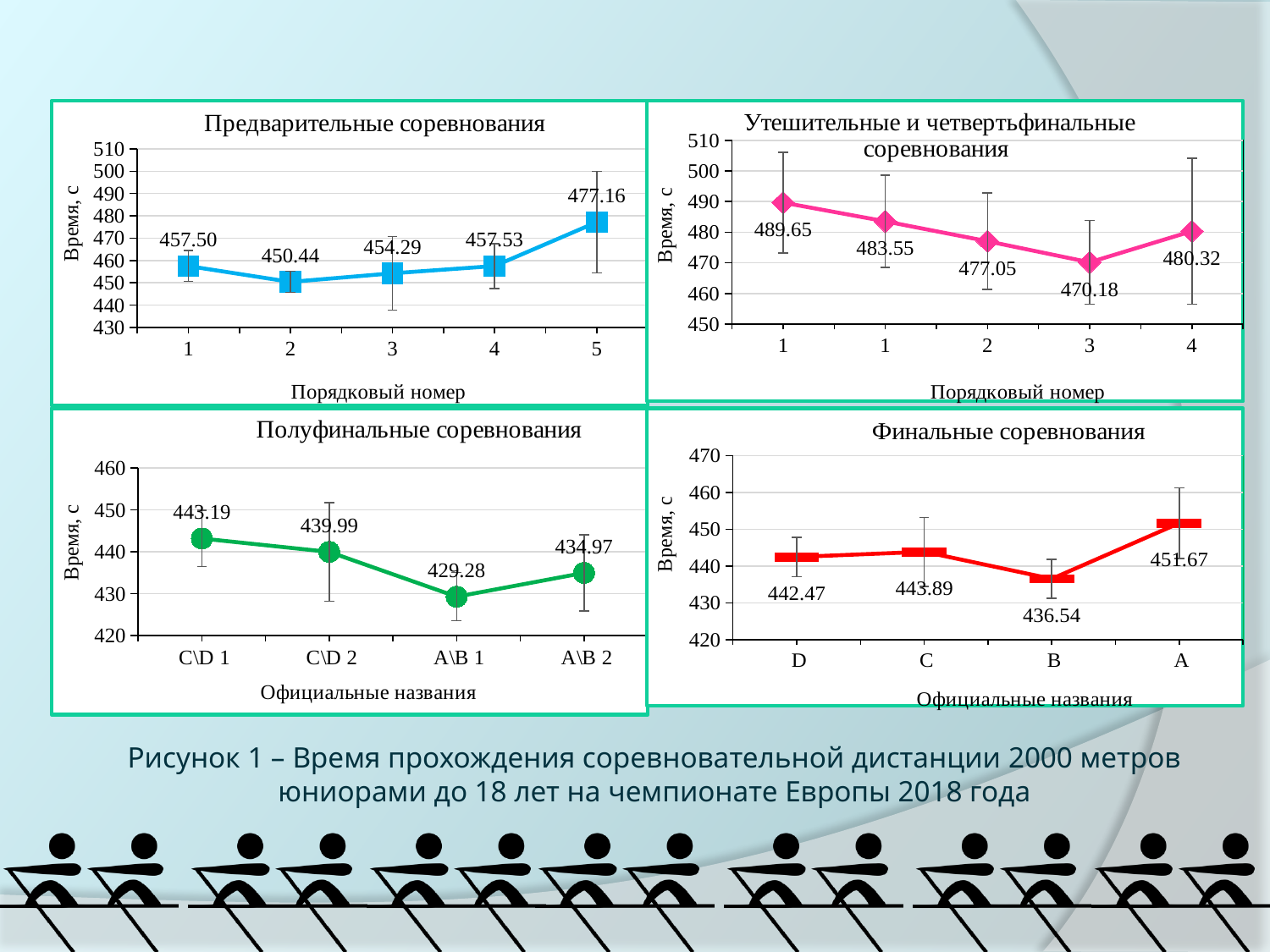
In the chart titled "Финальные соревнования", what is the value for A? 451.67 In the chart titled "Предварительные соревнования", what is the value for category 5? 477.16 In the chart titled "Предварительные соревнования", how many data points are plotted? 5 In the chart titled "Утешительные и четвертьфинальные соревнования", is the value for category 4 greater or less than 490? less In the chart titled "Полуфинальные соревнования", what is the value for A\B 1? 429.28 In the chart titled "Полуфинальные соревнования", which is larger, the value for C\D 1 or the value for A\B 2? C\D 1 In the chart titled "Утешительные и четвертьфинальные соревнования", which category has the highest value? the first category, 1 In the chart titled "Предварительные соревнования", what is the difference between the values for category 5 and category 2? 26.72 In the chart titled "Финальные соревнования", what is the difference between the values for A and B? 15.13 In the chart titled "Предварительные соревнования", which category has the lowest value? 2 In the chart titled "Утешительные и четвертьфинальные соревнования", what is the value for category 3? 470.18 What kind of chart is the chart titled "Финальные соревнования"? line chart